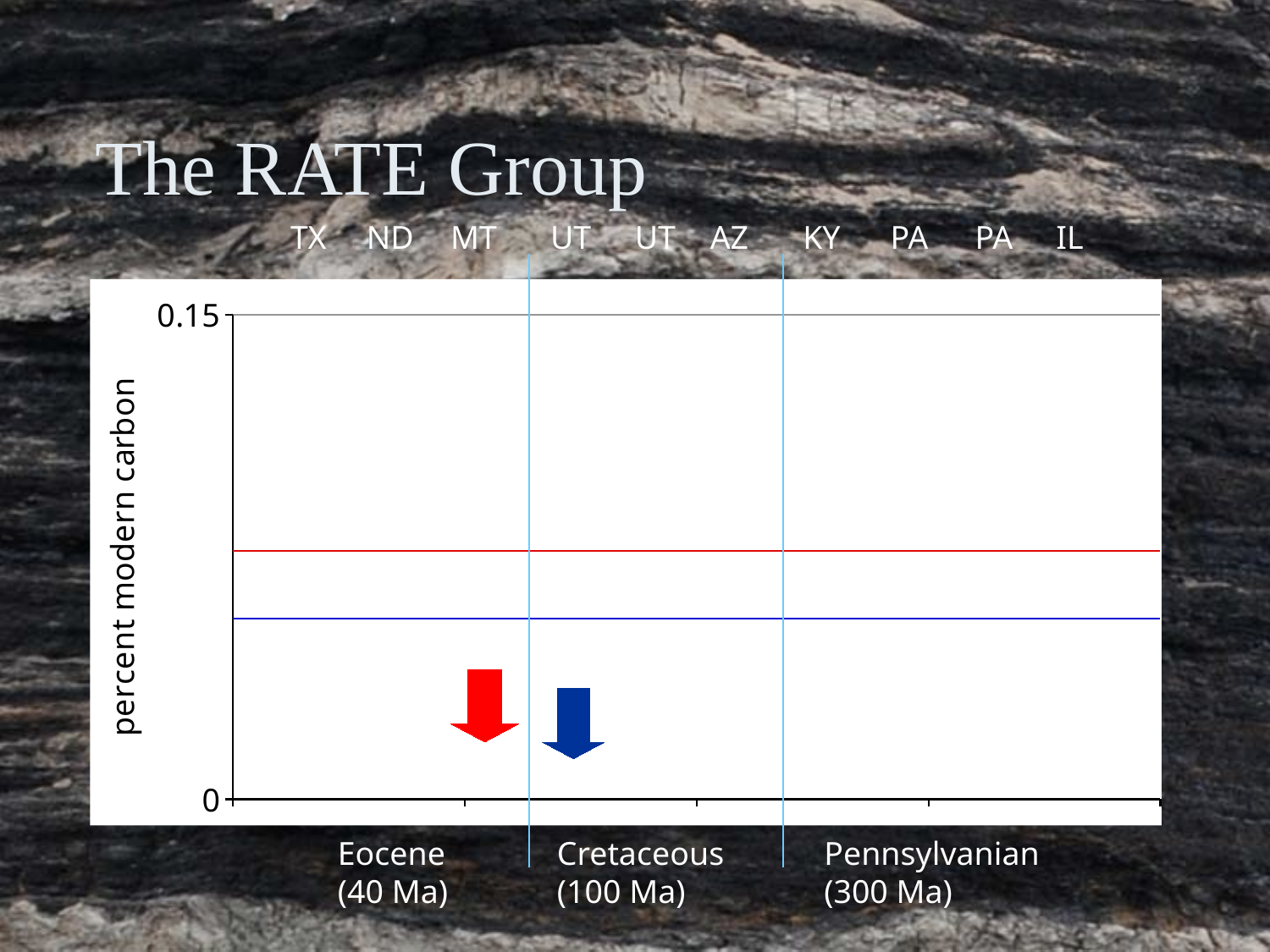
How many geological periods are labelled along the bottom of the chart? 3 What age is given for the Pennsylvanian group on the chart? 300 Ma Is the red horizontal line on the chart greater or less than 0.15 percent modern carbon? less What is the highest value shown on the vertical axis of the chart? 0.15 Which horizontal line on the chart is higher, the red line or the blue line? red What is the title of the slide containing the chart? The RATE Group How many state abbreviations are listed across the top of the chart? 10 What is the lowest value shown on the vertical axis of the chart? 0 Which geological period on the chart is labelled with 40 Ma? Eocene Is the blue horizontal line on the chart greater or less than 0 percent modern carbon? greater What age is given for the Cretaceous group on the chart? 100 Ma What is the label on the vertical axis of the chart? percent modern carbon